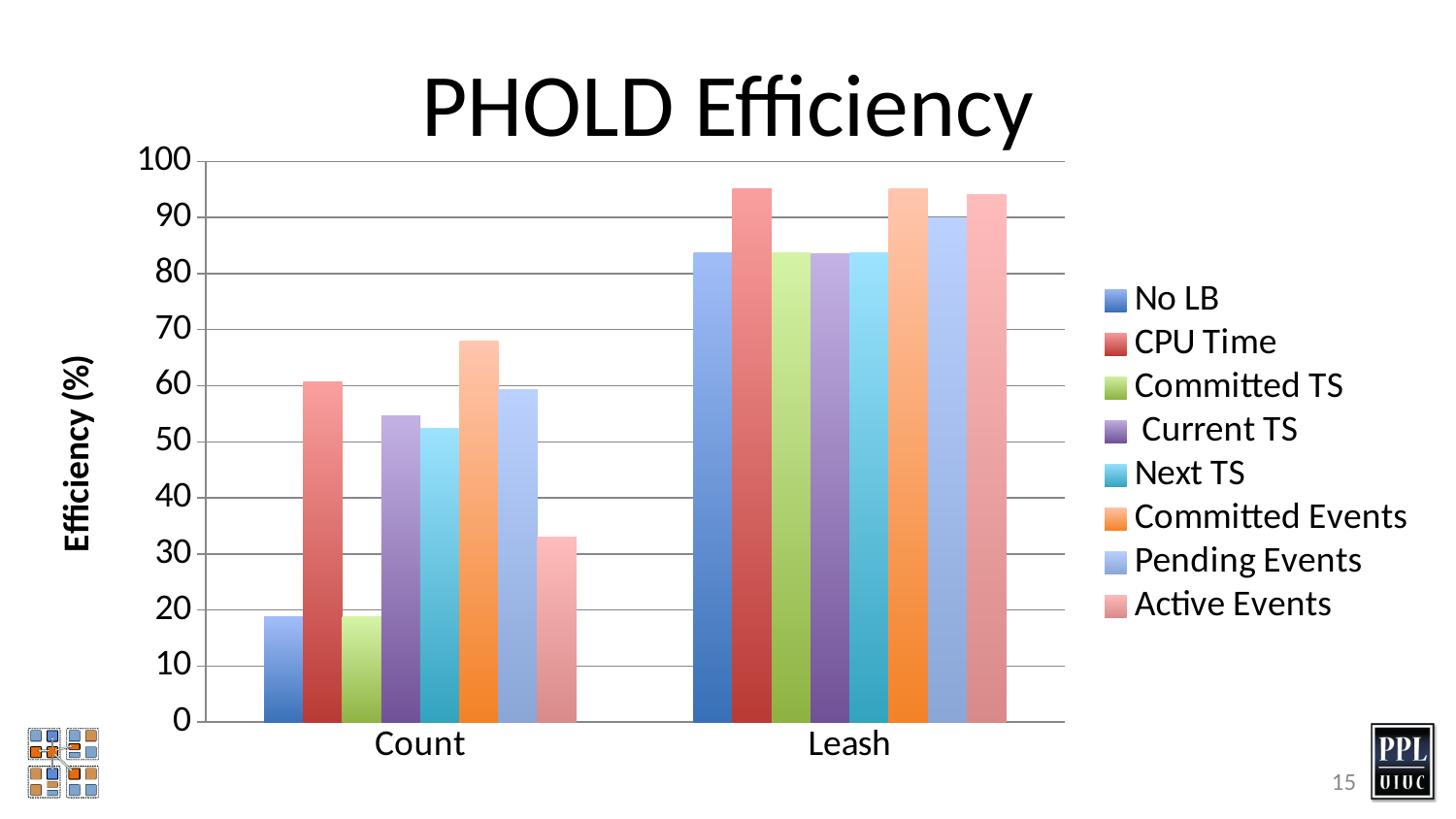
Which series has the highest value in the Count category? Committed Events In the Leash category, which is larger: Pending Events or No LB? Pending Events Is the value for Active Events in the Count category greater or less than 40? less In the Count category, which is larger: Pending Events or Active Events? Pending Events What kind of chart is shown on the slide? bar chart Do the values for No LB rise or fall from Count to Leash? rise How many series does the legend list? 8 Is the value for Pending Events in the Leash category greater or less than 80? greater Is the value for No LB in the Count category greater or less than 30? less What is the label on the y axis? Efficiency (%) How many categories are shown on the x axis? 2